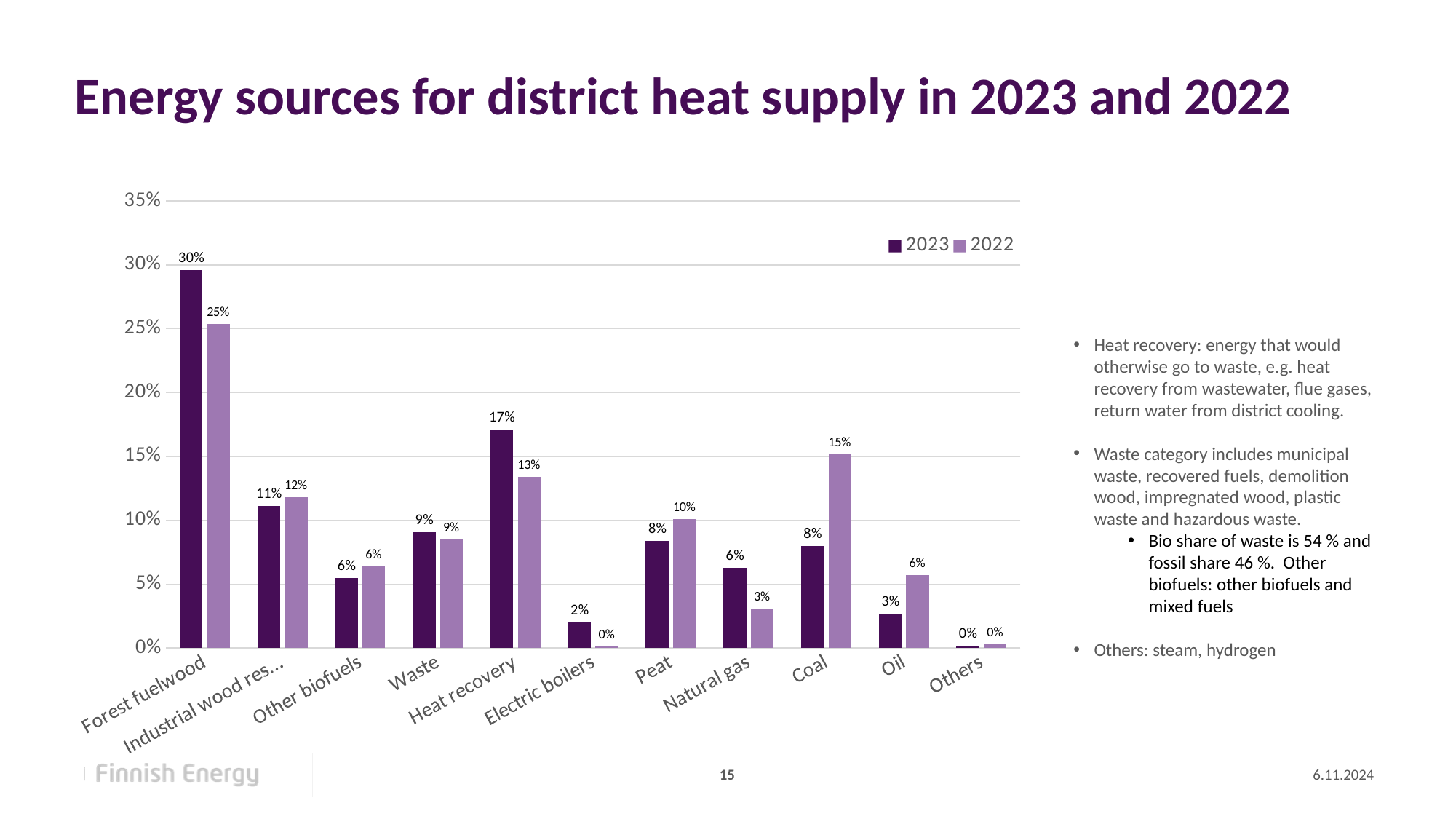
How many energy source categories are shown on the x axis? 11 What is the difference between the 2022 and 2023 values for Coal? 7 percentage points What is the value for Forest fuelwood in 2023? 30% What is the value for Coal in 2022? 15% Which category has the highest value in the 2022 series? Forest fuelwood Which category has the highest value in the 2023 series? Forest fuelwood What kind of chart is shown on the slide? Bar chart What is the difference between the 2023 and 2022 values for Forest fuelwood? 5 percentage points What is the value for Natural gas in 2022? 3% How many series does the legend list? 2 For Heat recovery, which year has the larger value, 2023 or 2022? 2023 What is the value for Heat recovery in 2023? 17%